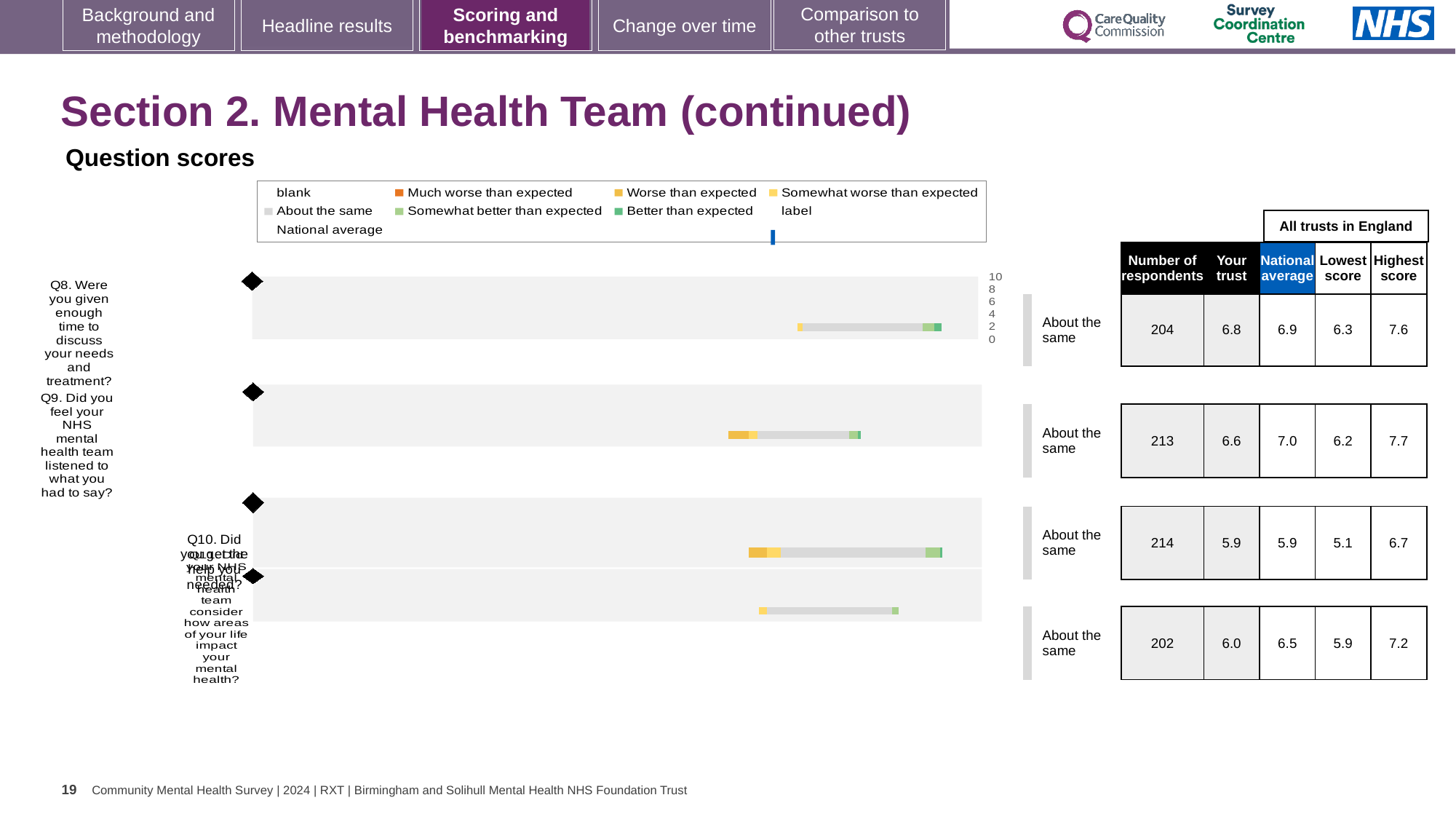
How many questions (bars) are plotted in the question scores chart? 4 For Q9, which is larger in the table beside the chart: the 'Your trust' score or the national average? National average In the table beside the chart, what is the national average score for Q10? 5.9 In the table beside the chart, how many respondents answered Q9? 213 In the chart legend, what colour represents 'Much worse than expected'? orange What kind of chart is used to show the question scores on this slide? bar chart According to the table beside the chart, which question has the highest 'Your trust' score? Q8 What benchmark label is shown next to the bar for Q8? About the same In the table beside the chart, what is the difference between the highest score and the lowest score for Q8? 1.3 According to the table beside the chart, which question has the lowest 'Your trust' score? Q10 In the chart legend, what colour represents 'Better than expected'? green In the table beside the chart, what is the highest score among all trusts in England for Q9? 7.7